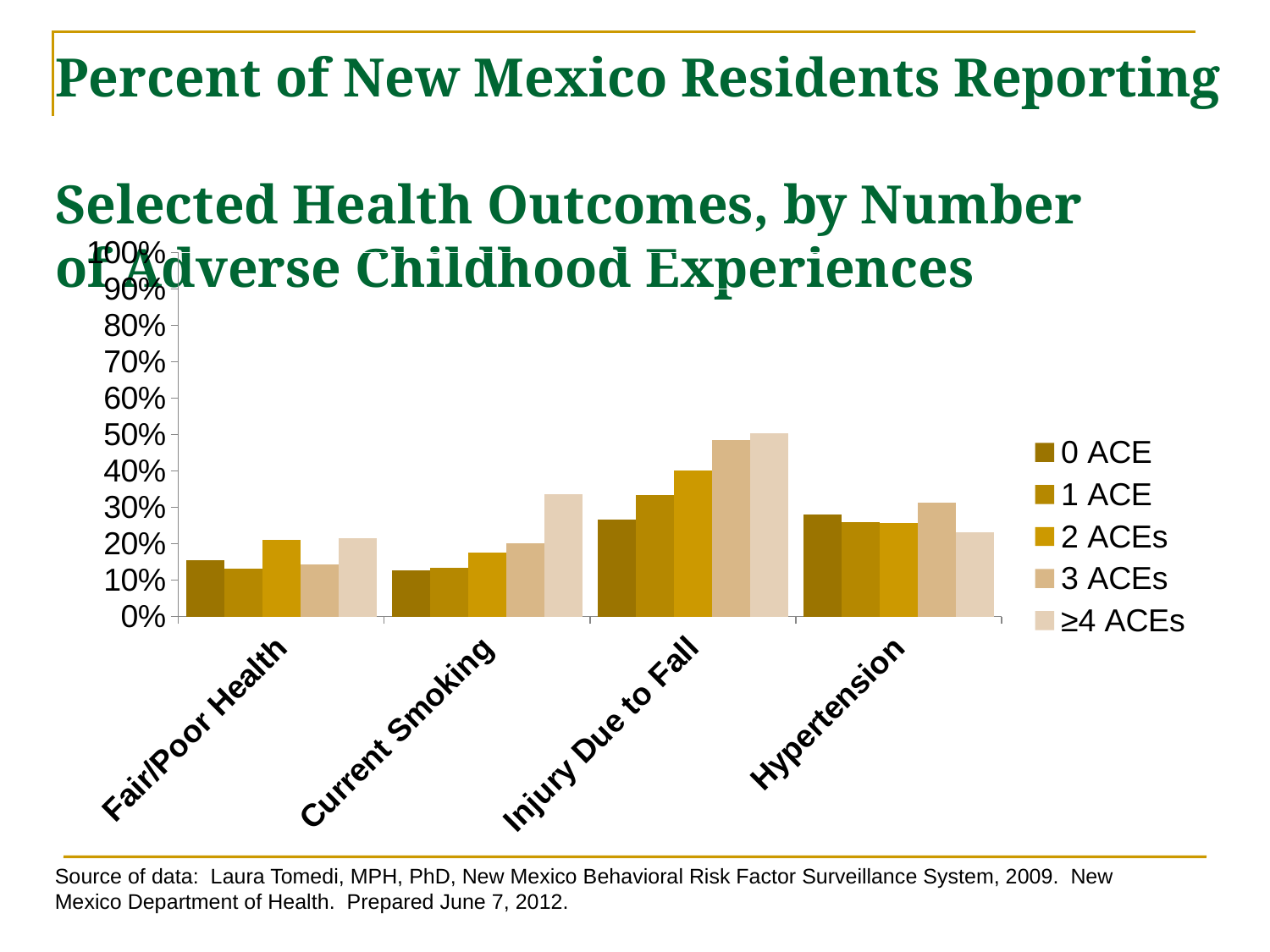
For Injury Due to Fall, which is larger: the value for 0 ACE or the value for 3 ACEs? 3 ACEs For Injury Due to Fall, do the values rise or fall as the number of ACEs increases from 0 ACE to ≥4 ACEs? rise How many health outcome categories are shown on the x axis? 4 Which health outcome has the tallest bar for the ≥4 ACEs series? Injury Due to Fall Is the value for Injury Due to Fall among residents with ≥4 ACEs greater or less than 40%? greater How many series does the legend list? 5 Which series is listed last in the legend? ≥4 ACEs Is the value for Current Smoking among residents with 0 ACE greater or less than 20%? less What kind of chart is shown on the slide? bar chart Is the value for Hypertension among residents with 3 ACEs greater or less than 20%? greater For Current Smoking, which is larger: the value for 2 ACEs or the value for ≥4 ACEs? ≥4 ACEs